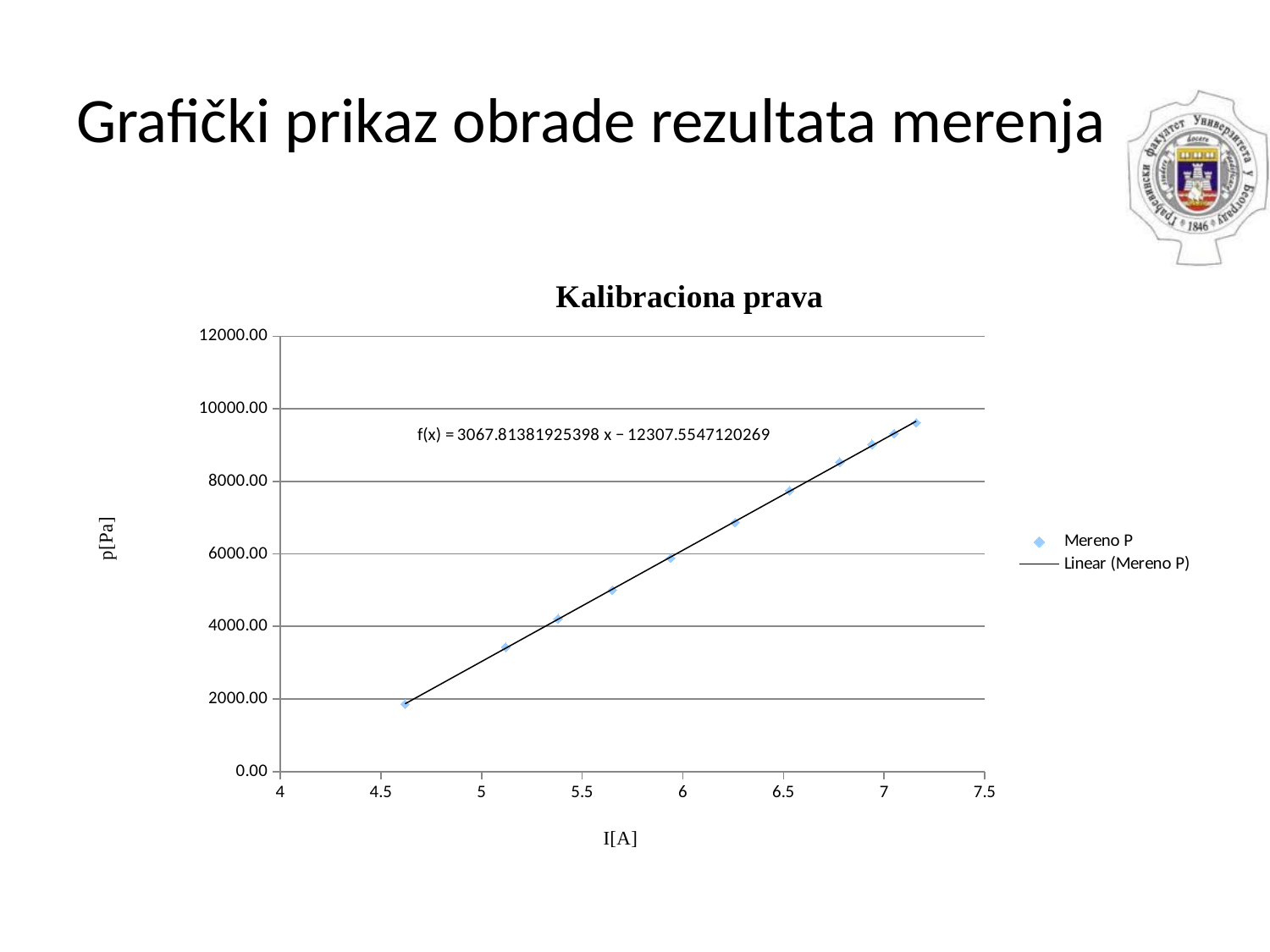
Do the plotted values of Mereno P rise or fall as I[A] increases? rise What type of chart is shown on the slide? scatter chart How many entries does the chart legend list? 2 Is the highest plotted value of Mereno P greater or less than 8000.00 Pa? greater Is the value of Mereno P at the point near I = 6.5 A greater or less than 6000.00 Pa? greater What is the slope of the linear fit shown in the equation on the chart? 3067.81381925398 What is the maximum value shown on the vertical axis of the chart? 12000.00 What is the title of the chart? Kalibraciona prava What are the two legend entries of the chart? Mereno P, Linear (Mereno P) What is the intercept of the linear fit shown in the equation on the chart? −12307.5547120269 Is the lowest plotted value of Mereno P greater or less than 4000.00 Pa? less How many data points of Mereno P are plotted on the chart? 11